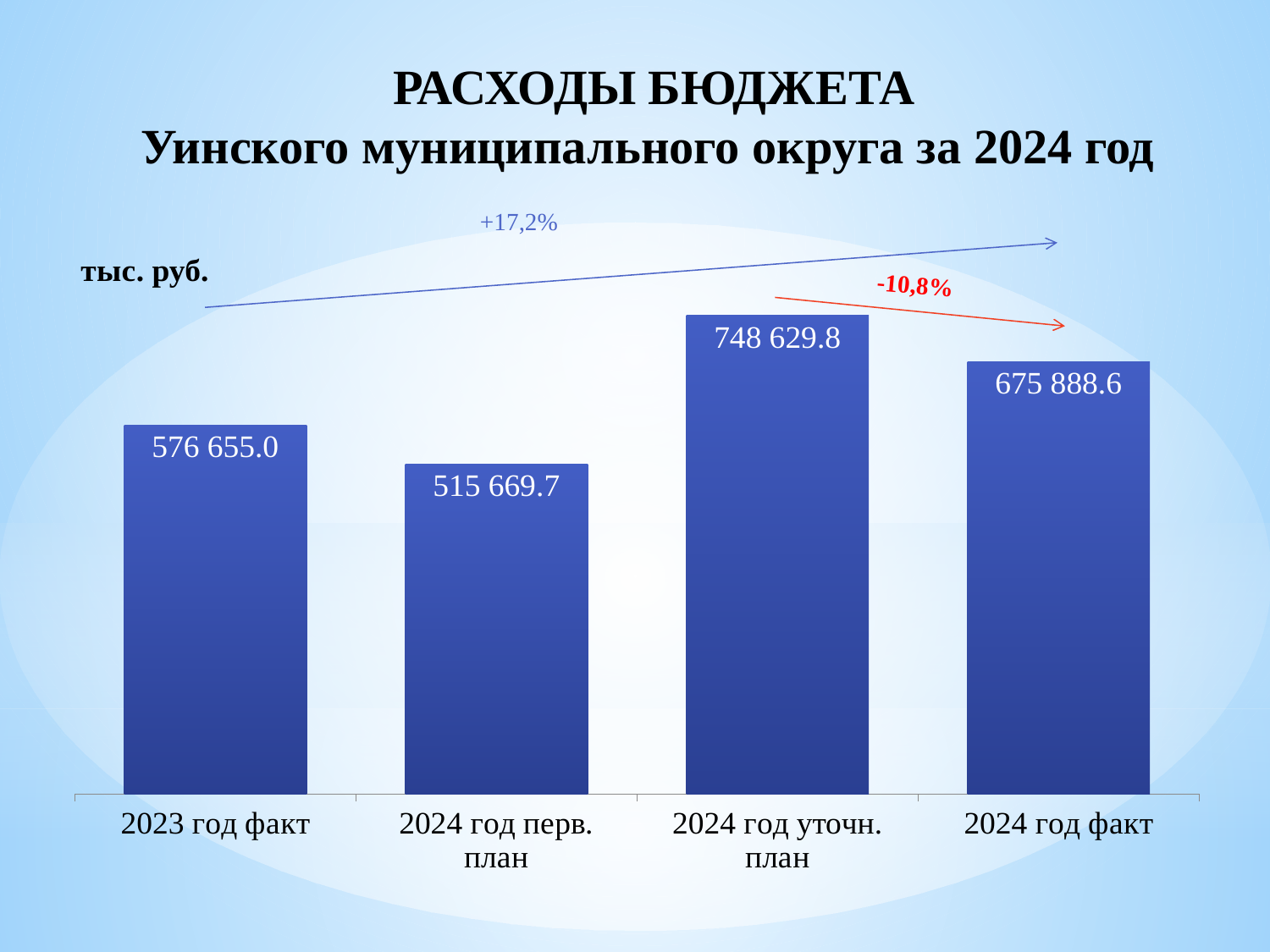
What is the value for 2024 год факт? 675 888.6 What is the value for 2023 год факт? 576 655.0 How many categories are shown in the chart? 4 What is the difference between 2024 год уточн. план and 2024 год факт? 72 741.2 What is the value for 2024 год уточн. план? 748 629.8 Which category has the highest value? 2024 год уточн. план What is the value for 2024 год перв. план? 515 669.7 What kind of chart is shown on the slide? bar chart Which category has the lowest value? 2024 год перв. план What unit of measurement is indicated for the chart values? тыс. руб. What is the difference between 2024 год факт and 2023 год факт? 99 233.6 Which is larger, 2023 год факт or 2024 год перв. план? 2023 год факт